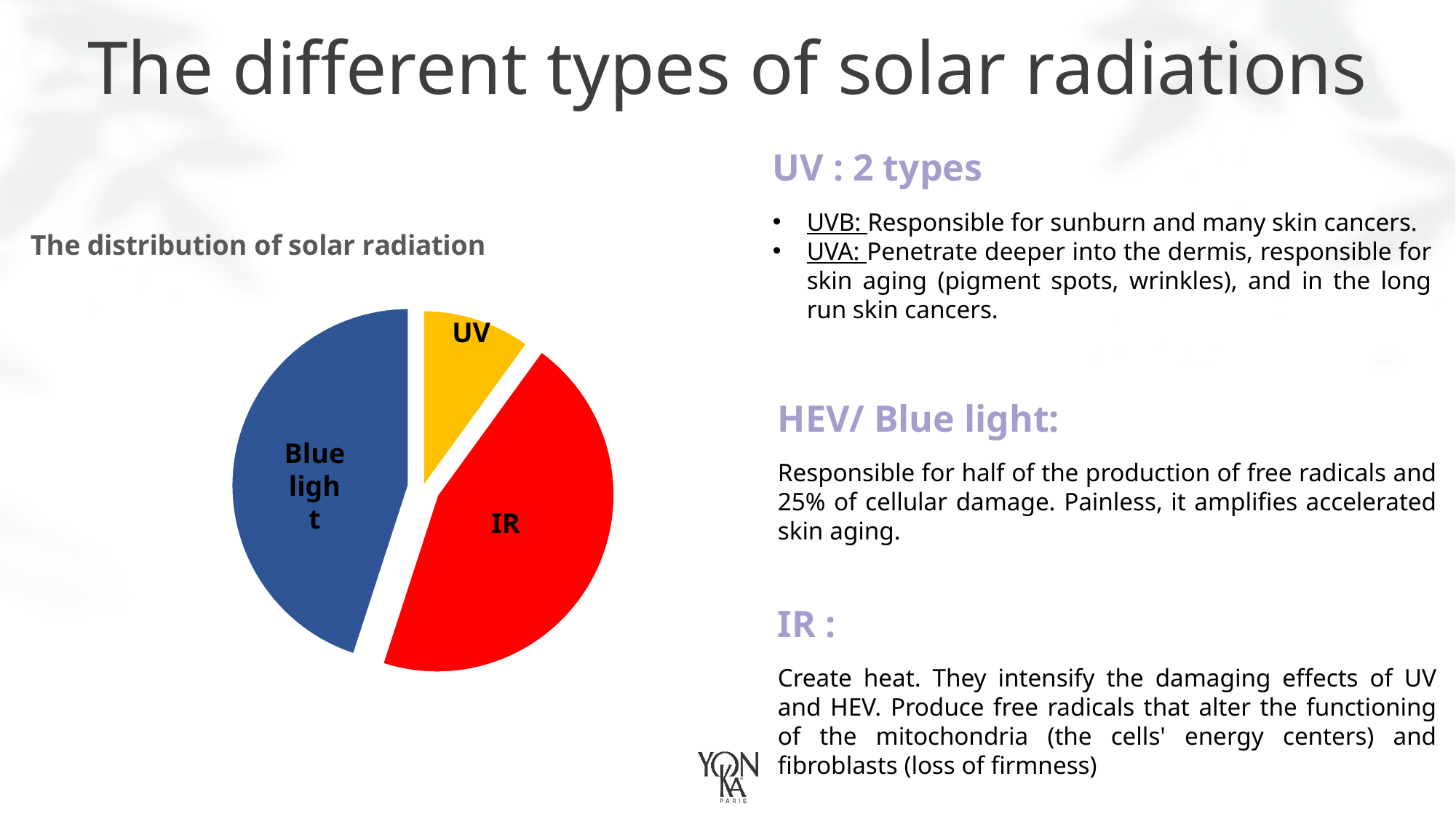
Which is larger in the pie chart, the UV slice or the IR slice? IR What kind of chart is shown on the slide? pie chart What is the title of the pie chart? The distribution of solar radiation What colour is the IR slice in the pie chart? red Which is larger in the pie chart, the UV slice or the Blue light slice? Blue light How many slices does the pie chart have? 3 Which slice of the pie chart is the smallest? UV